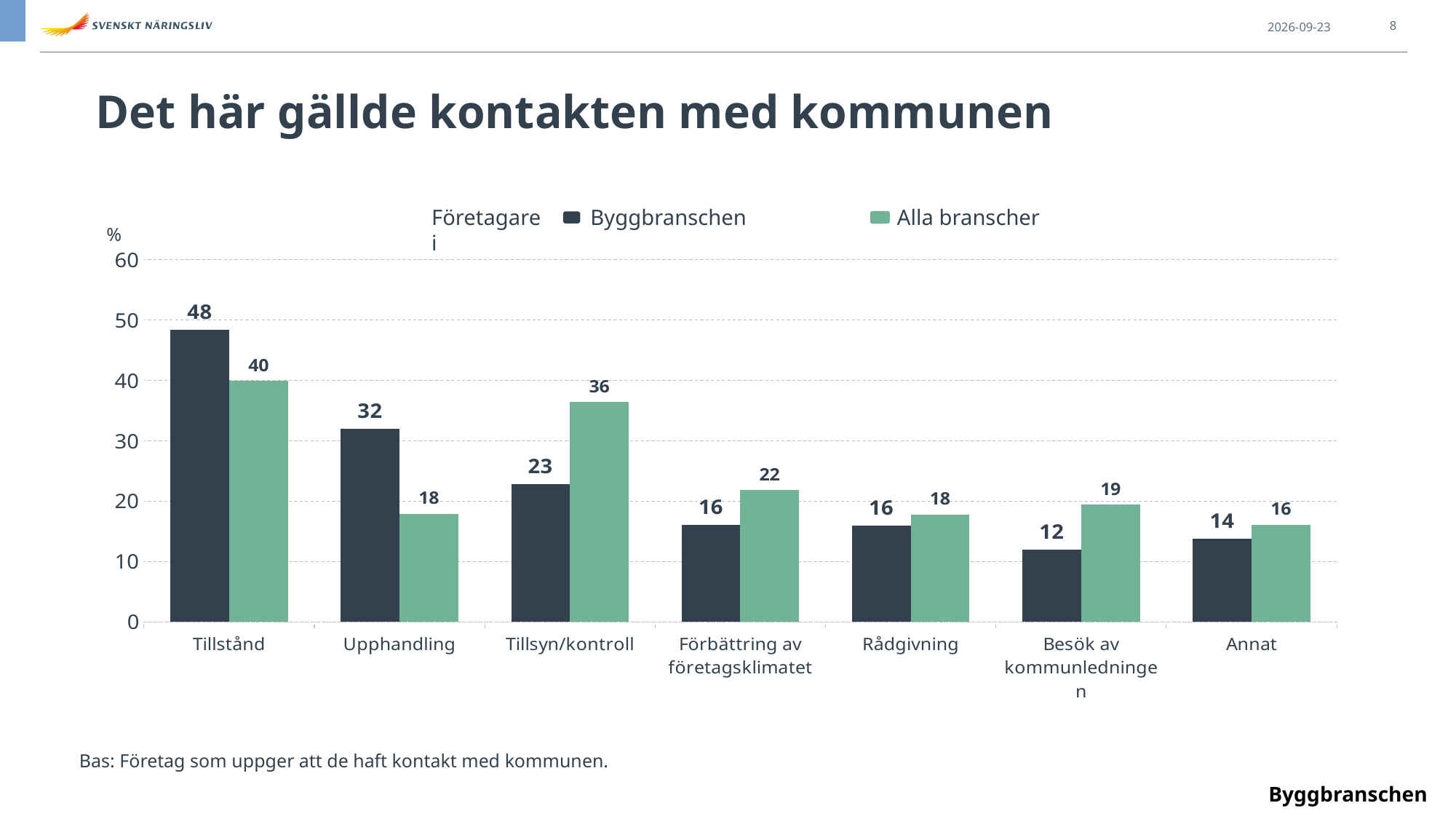
What is the value for Alla branscher in the Besök av kommunledningen category? 19 Which is larger in the Tillsyn/kontroll category, Byggbranschen or Alla branscher? Alla branscher What is the difference between Byggbranschen and Alla branscher in the Upphandling category? 14 What is the value for Alla branscher in the Tillsyn/kontroll category? 36 What kind of chart is shown on the slide? Bar chart Which category has the highest value for Byggbranschen? Tillstånd How many series does the legend list? 2 What is the title of the slide? Det här gällde kontakten med kommunen What is the value for Byggbranschen in the Tillstånd category? 48 How many categories are shown on the x axis? 7 Which category has the lowest value for Byggbranschen? Besök av kommunledningen Is the value for Alla branscher in the Tillstånd category greater or less than 30? greater